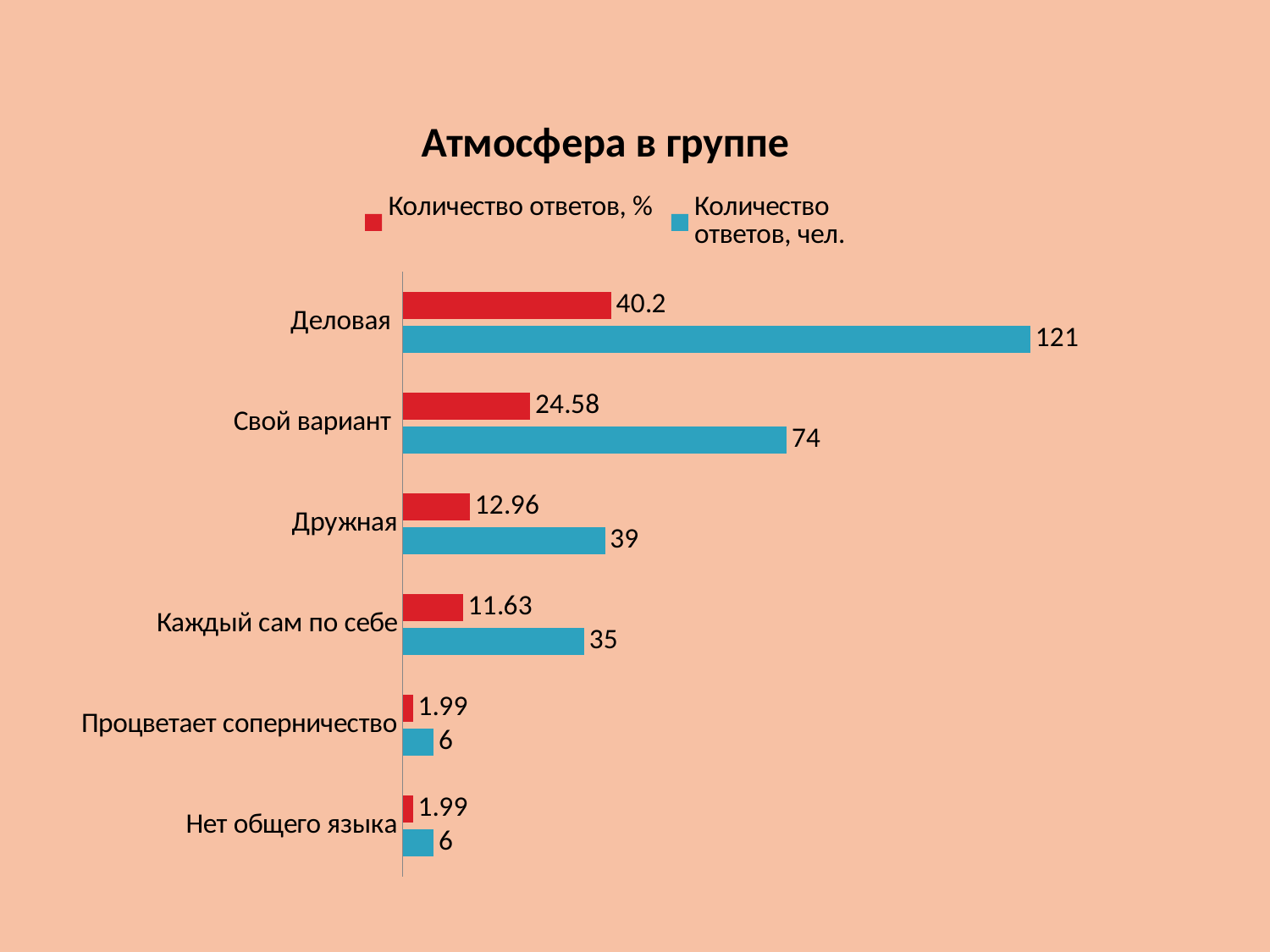
What is the title of the chart? Атмосфера в группе What is the difference between the 'Количество ответов, %' values for 'Деловая' and 'Дружная'? 27.24 What is the value of 'Количество ответов, %' for 'Свой вариант'? 24.58 What kind of chart is shown on the slide? bar chart Which category has the highest value for 'Количество ответов, чел.'? Деловая How many series does the legend list? 2 What is the difference between the 'Количество ответов, чел.' values for 'Деловая' and 'Свой вариант'? 47 What is the value of 'Количество ответов, %' for 'Каждый сам по себе'? 11.63 What is the value of 'Количество ответов, чел.' for 'Деловая'? 121 Which is larger: the 'Количество ответов, чел.' value for 'Дружная' or for 'Каждый сам по себе'? Дружная How many categories are shown on the chart? 6 What is the value of 'Количество ответов, чел.' for 'Дружная'? 39